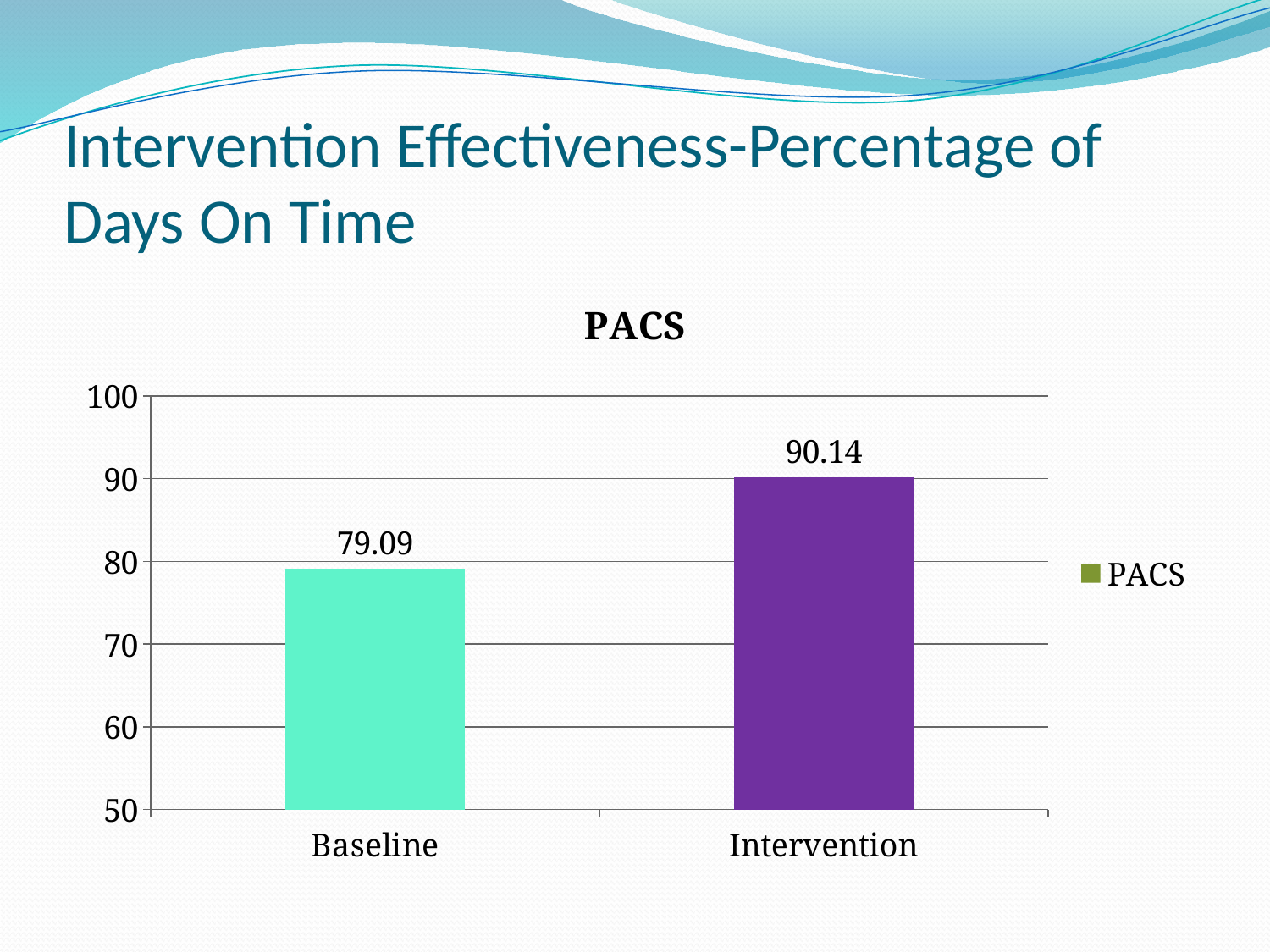
Which category has the highest value? Intervention Is the value for Baseline greater or less than 80? less What kind of chart is shown? bar chart What is the difference between the Intervention and Baseline values? 11.05 What is the value for Intervention? 90.14 What is the value for Baseline? 79.09 Is the value for Intervention greater or less than 90? greater Which is larger, the value for Baseline or the value for Intervention? Intervention What is the title of the chart? PACS How many categories are shown on the x axis? 2 Which category has the lowest value? Baseline How many series does the legend list? 1